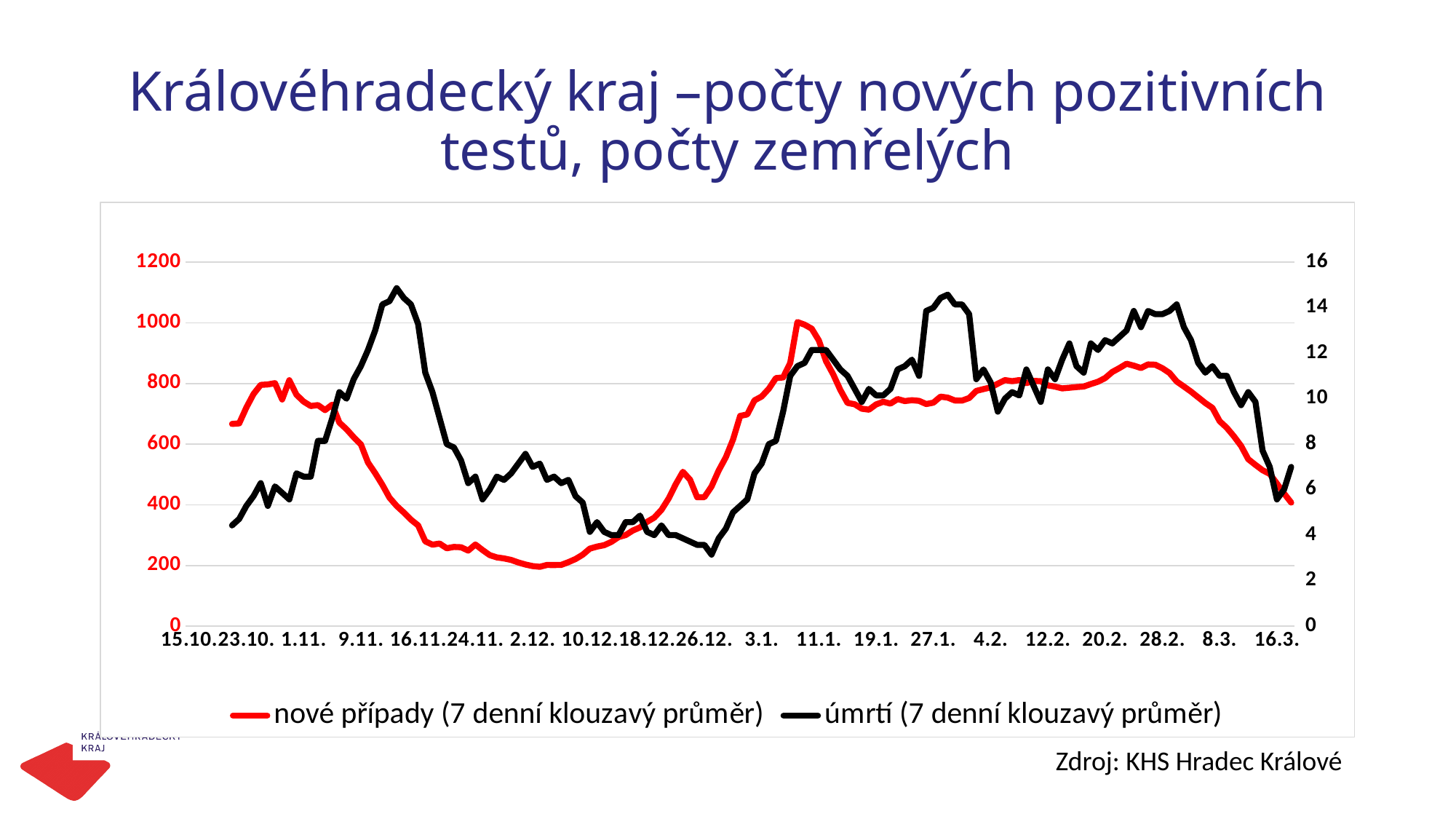
Is the value of the black line (úmrtí) at its peak around 16.11. greater or less than 12 on the right axis? greater What kind of chart is shown on the slide? line chart Is the value of the red line (nové případy) at 16.11. greater or less than 400? less Which series is drawn in red according to the legend? nové případy (7 denní klouzavý průměr) Is the value of the black line (úmrtí) at 26.12. greater or less than 6 on the right axis? less How many series does the legend list? 2 What is the highest value shown on the left vertical axis? 1200 Does the red line (nové případy) rise or fall between 10.12. and 11.1.? rise Does the black line (úmrtí) rise or fall between 16.11. and 26.12.? fall Does the red line (nové případy) rise or fall between 1.11. and 2.12.? fall